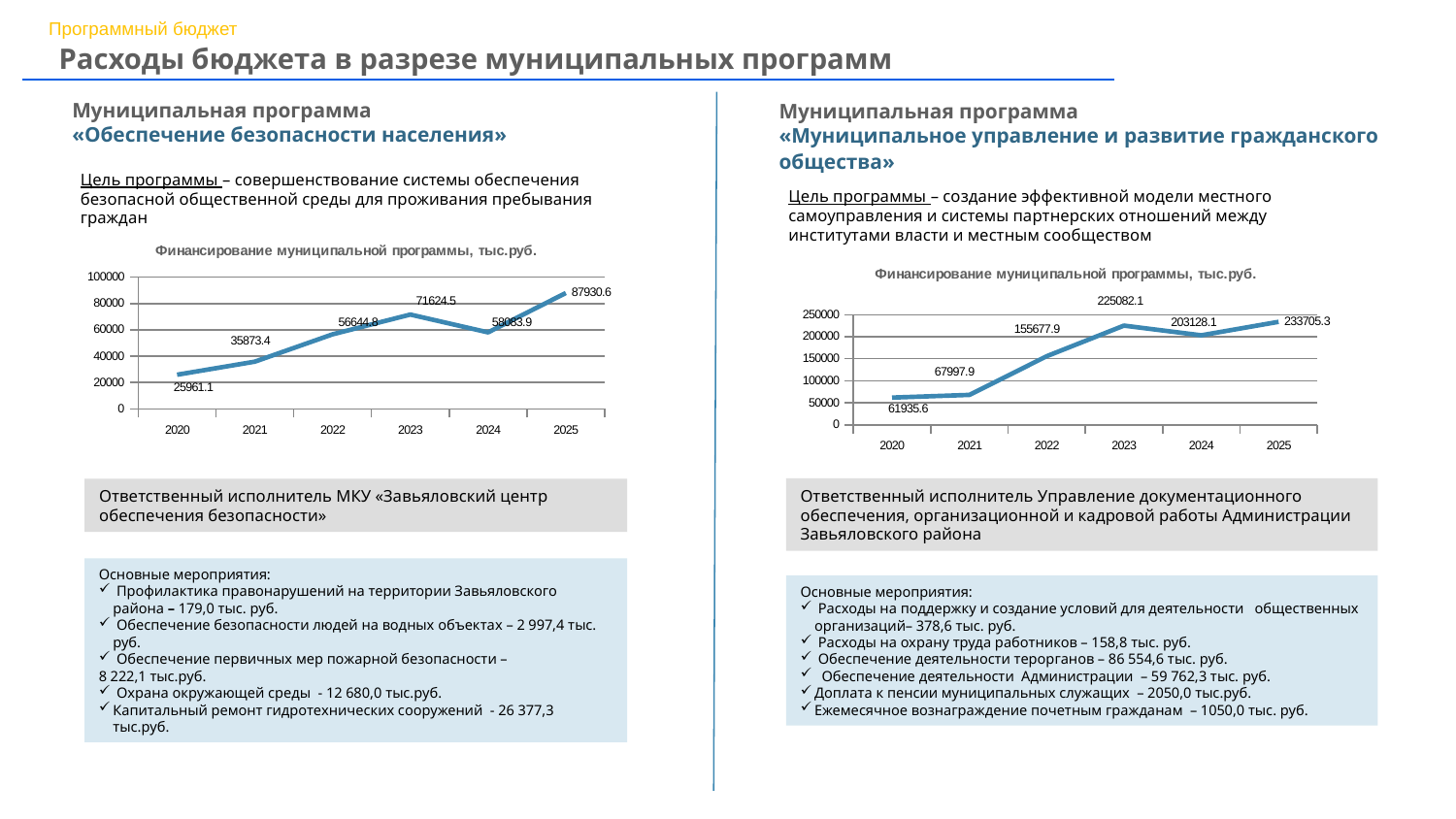
On the left chart, what is the difference between the values for 2025 and 2020? 61969.5 On the left chart, what is the value for 2020? 25961.1 On the left chart, how many years are plotted? 6 On the right chart, what is the value for 2022? 155677.9 On the left chart, what is the value for 2023? 71624.5 On the left chart, which year has the highest value? 2025 On the right chart, what is the value for 2025? 233705.3 On the right chart, which is larger, the value for 2023 or the value for 2024? 2023 On the right chart, what is the difference between the values for 2021 and 2020? 6062.3 What type of chart is the right chart? line chart On the right chart, which year has the lowest value? 2020 On the left chart, which year has the lowest value? 2020